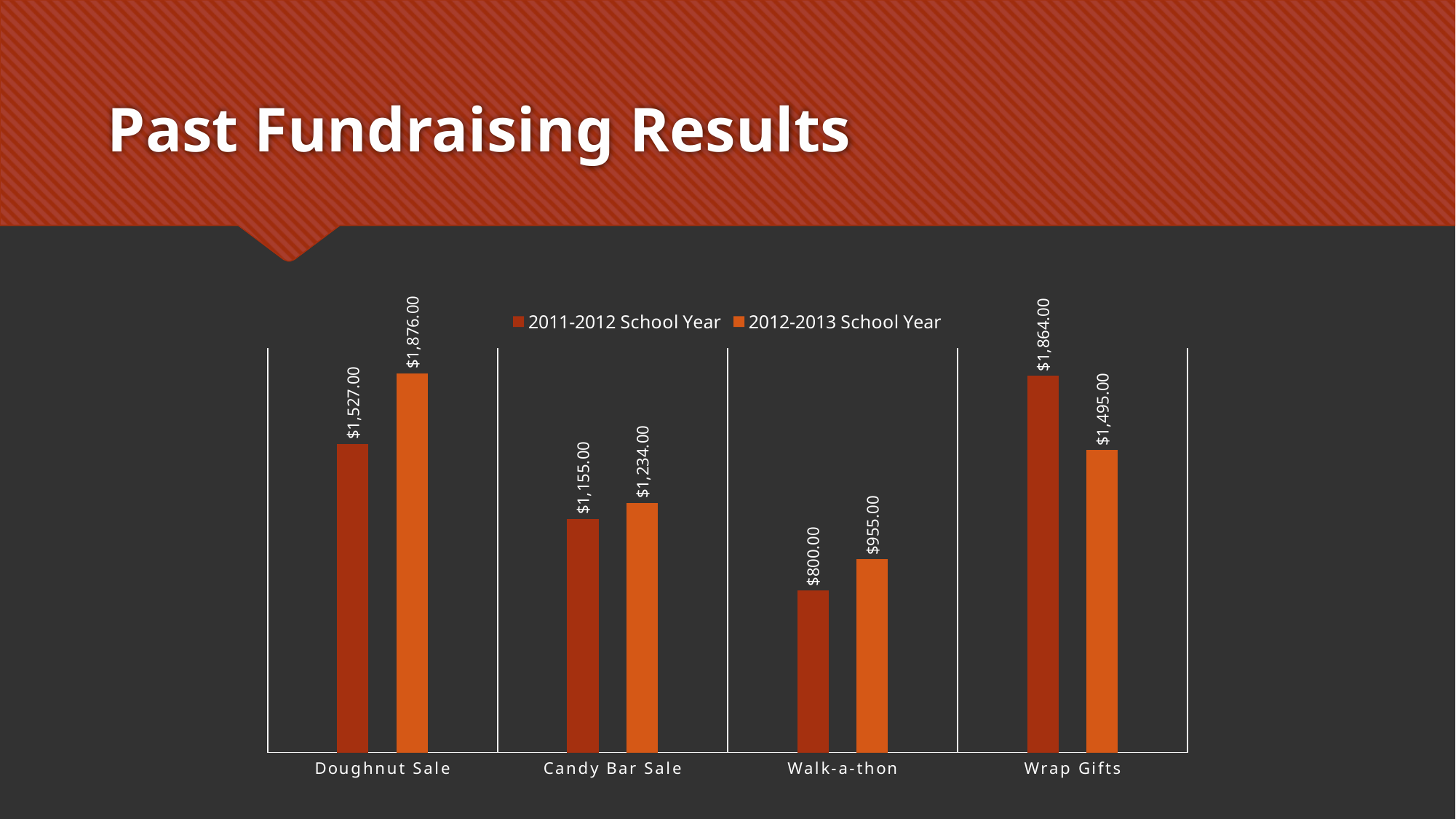
Which was larger for Wrap Gifts: the 2011-2012 School Year or the 2012-2013 School Year? 2011-2012 School Year What was the Walk-a-thon result for the 2011-2012 School Year? $800.00 Which fundraiser had the lowest result in the 2012-2013 School Year? Walk-a-thon How many series does the legend list? 2 What is the title of the slide containing the chart? Past Fundraising Results Which fundraiser had the highest result in the 2011-2012 School Year? Wrap Gifts What was the Doughnut Sale result for the 2012-2013 School Year? $1,876.00 What is the difference between the 2012-2013 and 2011-2012 Candy Bar Sale results? $79.00 What is the difference between the Doughnut Sale results for 2012-2013 and 2011-2012? $349.00 What was the Wrap Gifts result for the 2012-2013 School Year? $1,495.00 How many fundraisers are shown on the x axis? 4 What kind of chart is shown on the slide? Bar chart